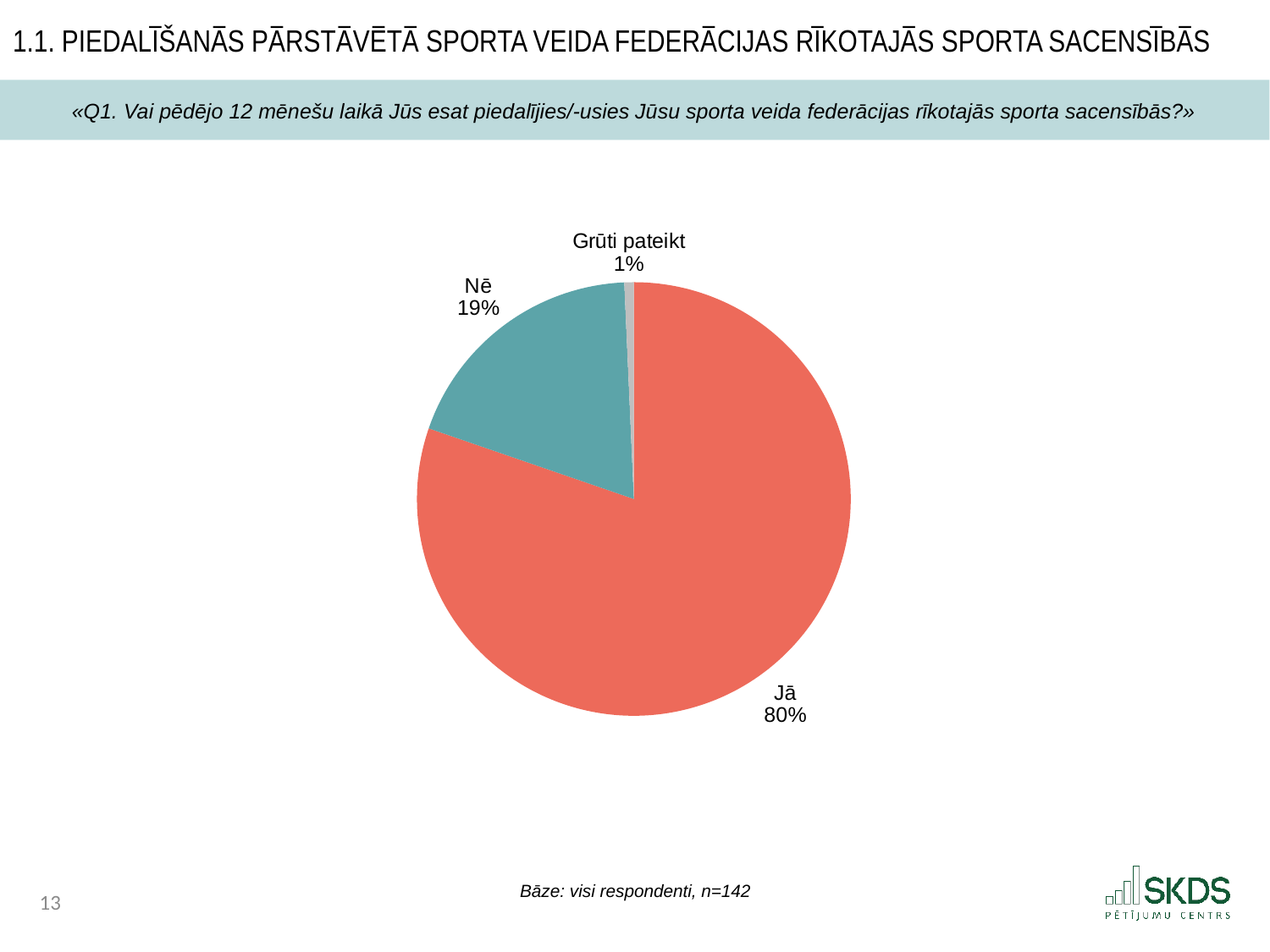
What is the base (n) stated below the chart? n=142 What is the difference in percentage points between "Jā" and "Nē"? 61 What is the combined share of "Nē" and "Grūti pateikt"? 20% How many slices does the pie chart have? 3 What colour is the "Jā" slice? red Which is larger, the share for "Nē" or the share for "Grūti pateikt"? Nē What percentage of respondents answered "Grūti pateikt"? 1% What percentage of respondents answered "Jā"? 80% Which response has the largest share of the pie? Jā What percentage of respondents answered "Nē"? 19% Which response has the smallest share of the pie? Grūti pateikt What type of chart is shown on the slide? pie chart